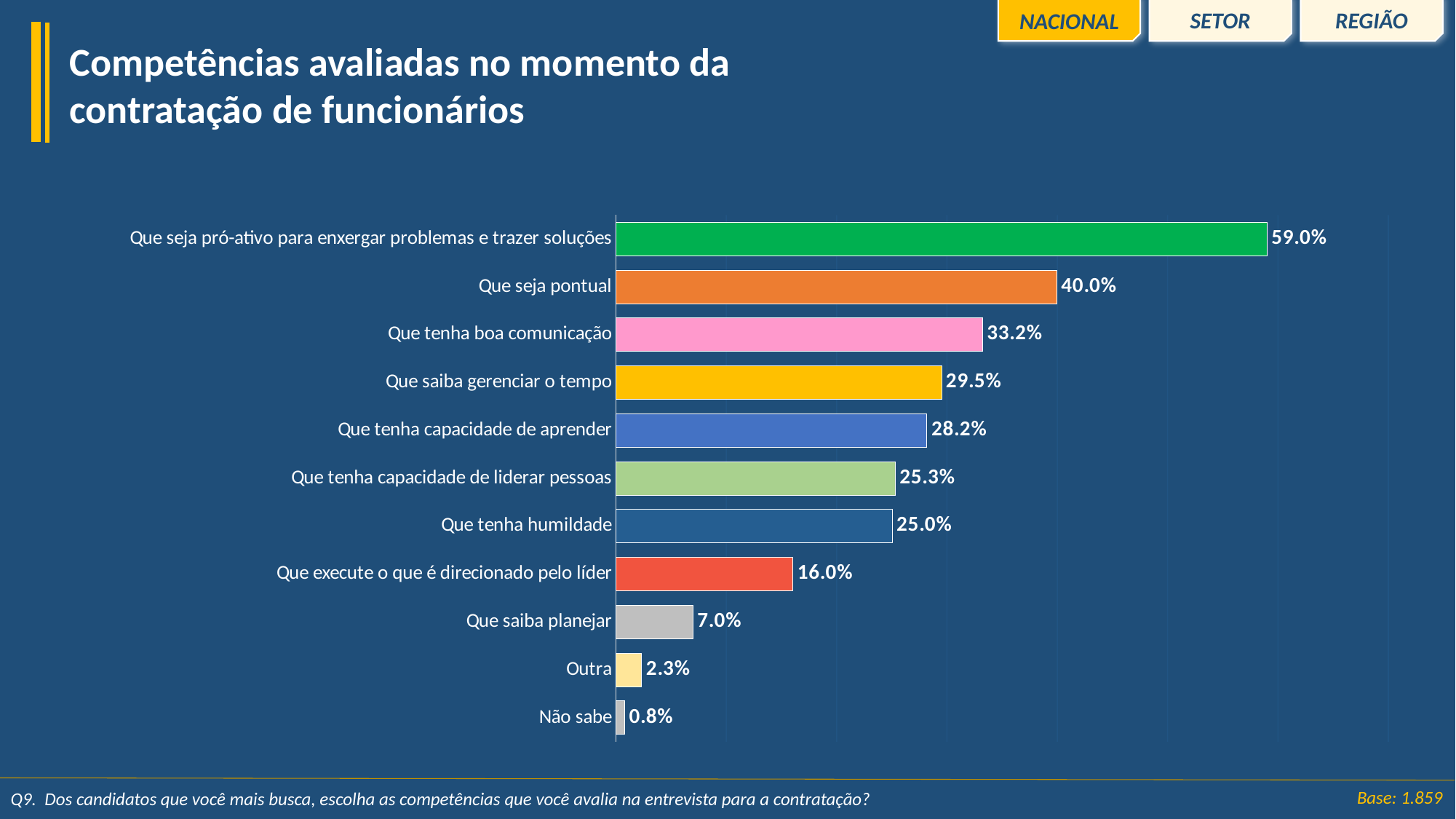
What is the value for "Outra"? 2.3% Which is larger: "Que tenha capacidade de aprender" or "Que tenha humildade"? Que tenha capacidade de aprender What is the title of the chart on the slide? Competências avaliadas no momento da contratação de funcionários Which category has the lowest value? Não sabe How many categories are shown in the chart? 11 What is the value for "Que seja pontual"? 40.0% Which category has the highest value? Que seja pró-ativo para enxergar problemas e trazer soluções What is the value for "Que saiba planejar"? 7.0% What is the difference between "Que seja pró-ativo para enxergar problemas e trazer soluções" and "Que seja pontual"? 19.0% What kind of chart is shown on the slide? Bar chart What is the value for "Que tenha capacidade de liderar pessoas"? 25.3% What is the difference between "Que tenha boa comunicação" and "Que saiba gerenciar o tempo"? 3.7%